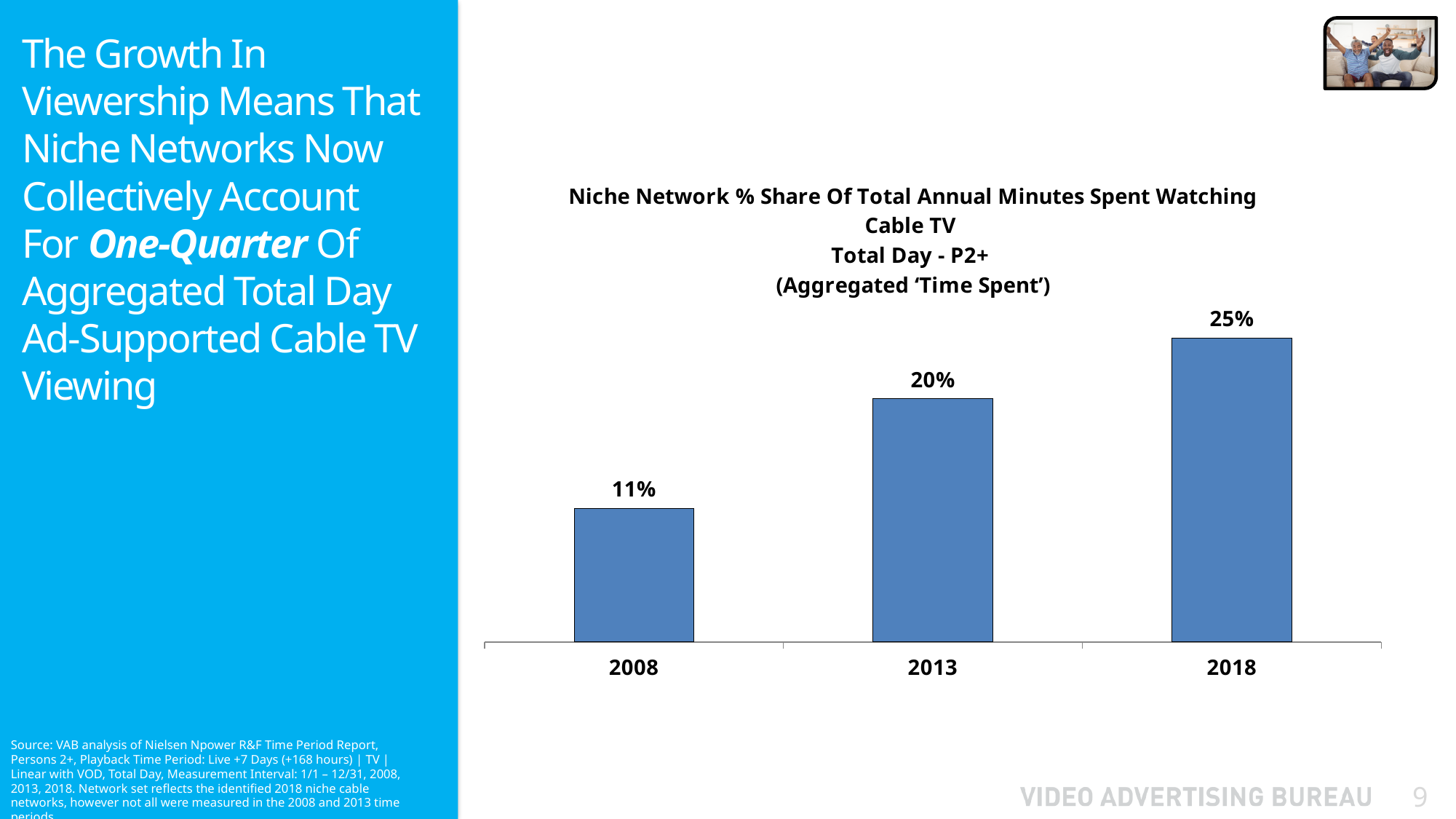
What is the difference between the 2013 and 2018 niche network share values? 5 percentage points What kind of chart is shown on the slide? Bar chart Which year has a larger niche network share, 2008 or 2013? 2013 By how many percentage points did the niche network share grow from 2008 to 2018? 14 percentage points What is the niche network share of total annual minutes spent watching cable TV in 2008? 11% How many years are shown on the chart? 3 Which year has the lowest niche network share? 2008 What audience demographic is named in the chart title? P2+ Which year has the highest niche network share? 2018 What is the niche network share of total annual minutes spent watching cable TV in 2013? 20% Do the niche network share values rise or fall from 2008 to 2018? Rise What is the niche network share of total annual minutes spent watching cable TV in 2018? 25%